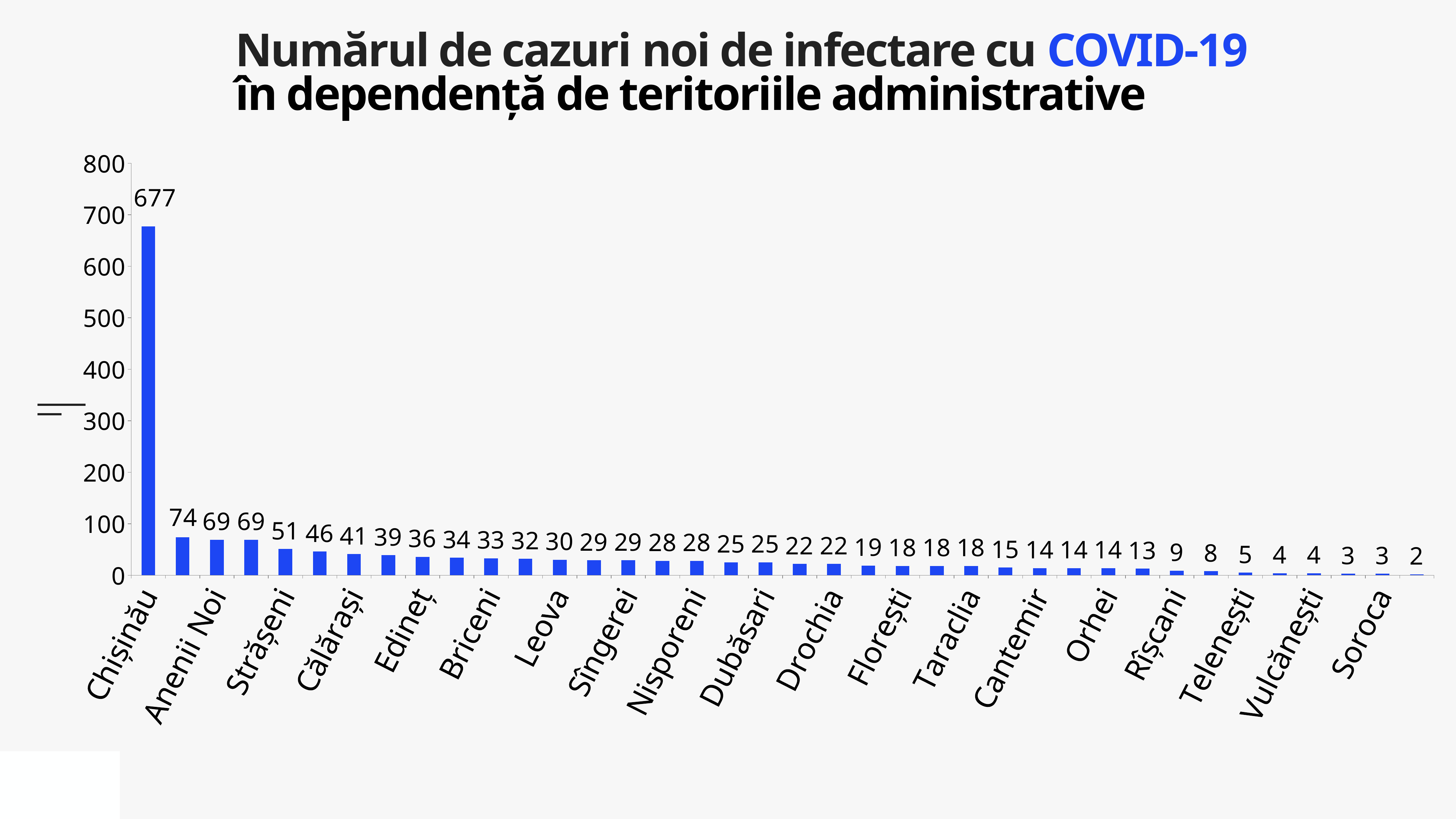
Which administrative territory has the highest number of new cases? Chișinău What is the lowest value shown on the chart? 2 How many bars exceed 100 cases? 1 What is the highest value shown on the chart? 677 Is the value for Chișinău greater or less than 600? greater What colour are the bars in the chart? blue What kind of chart is shown on the slide? bar chart How many bars are plotted on the chart? 38 What is the difference between the highest value (677) and the second highest value (74)? 603 What is the number of new COVID-19 cases shown for Chișinău? 677 Do the values rise or fall from left to right along the x axis? fall What is the title of the chart? Numărul de cazuri noi de infectare cu COVID-19 în dependență de teritoriile administrative